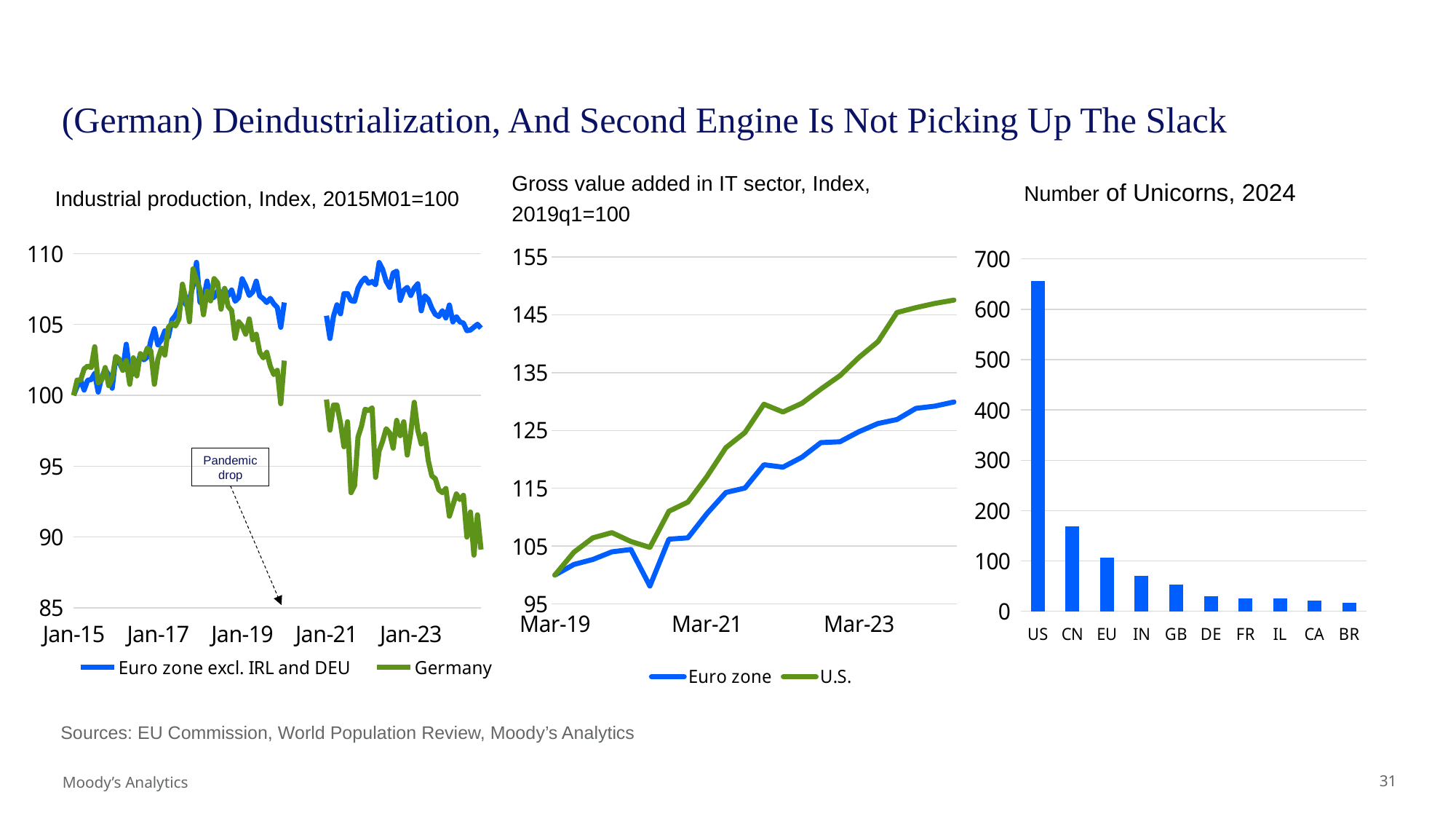
In the 'Gross value added in IT sector' chart, is the final value of the U.S. series greater or less than 145? greater What kind of chart is the 'Number of Unicorns, 2024' chart? bar chart In the 'Number of Unicorns, 2024' chart, is the value for US greater or less than 600? greater How many series does the legend of the 'Gross value added in IT sector' chart list? 2 In the 'Number of Unicorns, 2024' chart, which country has the lowest number of unicorns? BR In the 'Number of Unicorns, 2024' chart, how many countries or regions are shown? 10 In the 'Gross value added in IT sector' chart, which series is higher at the end of the period, Euro zone or U.S.? U.S. In the 'Industrial production' chart, is the final value of the Germany series greater or less than 90? less In the 'Number of Unicorns, 2024' chart, which has more unicorns, CN or EU? CN In the 'Number of Unicorns, 2024' chart, which country has the highest number of unicorns? US What kind of chart is the 'Gross value added in IT sector' chart? line chart